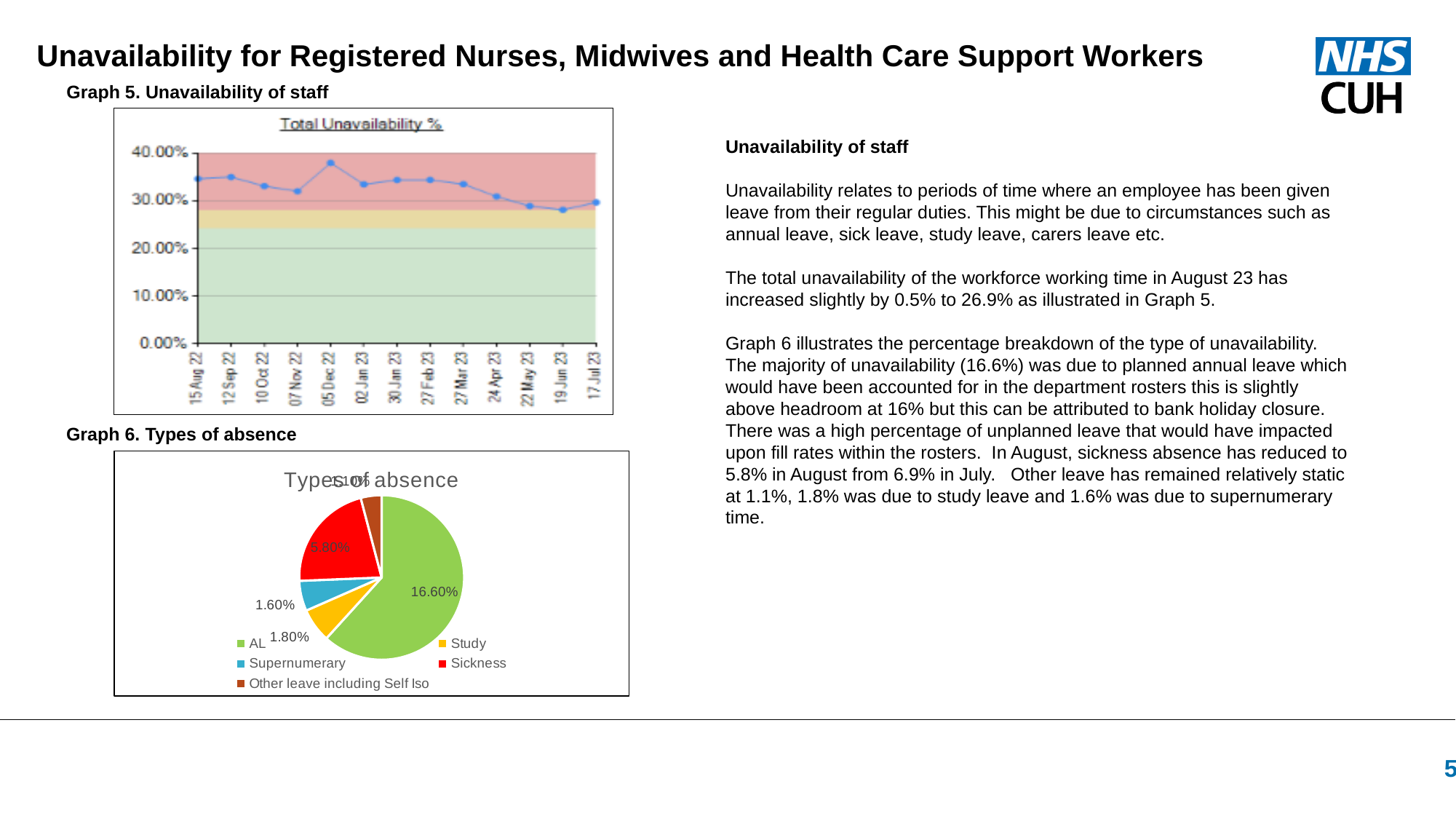
In Graph 6. Types of absence, what percentage is shown for Study? 1.80% What kind of chart is Graph 5. Unavailability of staff? line chart In Graph 5. Unavailability of staff, is the value for 05 Dec 22 greater or less than 30.00%? greater In Graph 6. Types of absence, what percentage is shown for Supernumerary? 1.60% How many data points are plotted in Graph 5. Unavailability of staff? 13 What kind of chart is Graph 6. Types of absence? pie chart In Graph 5. Unavailability of staff, which date has the highest total unavailability? 05 Dec 22 In Graph 6. Types of absence, what percentage is shown for AL? 16.60% In Graph 6. Types of absence, what is the difference between the AL and Sickness percentages? 10.80% In Graph 6. Types of absence, which type of absence has the largest slice? AL In Graph 6. Types of absence, what percentage is shown for Sickness? 5.80% How many entries does the legend of Graph 6. Types of absence list? 5